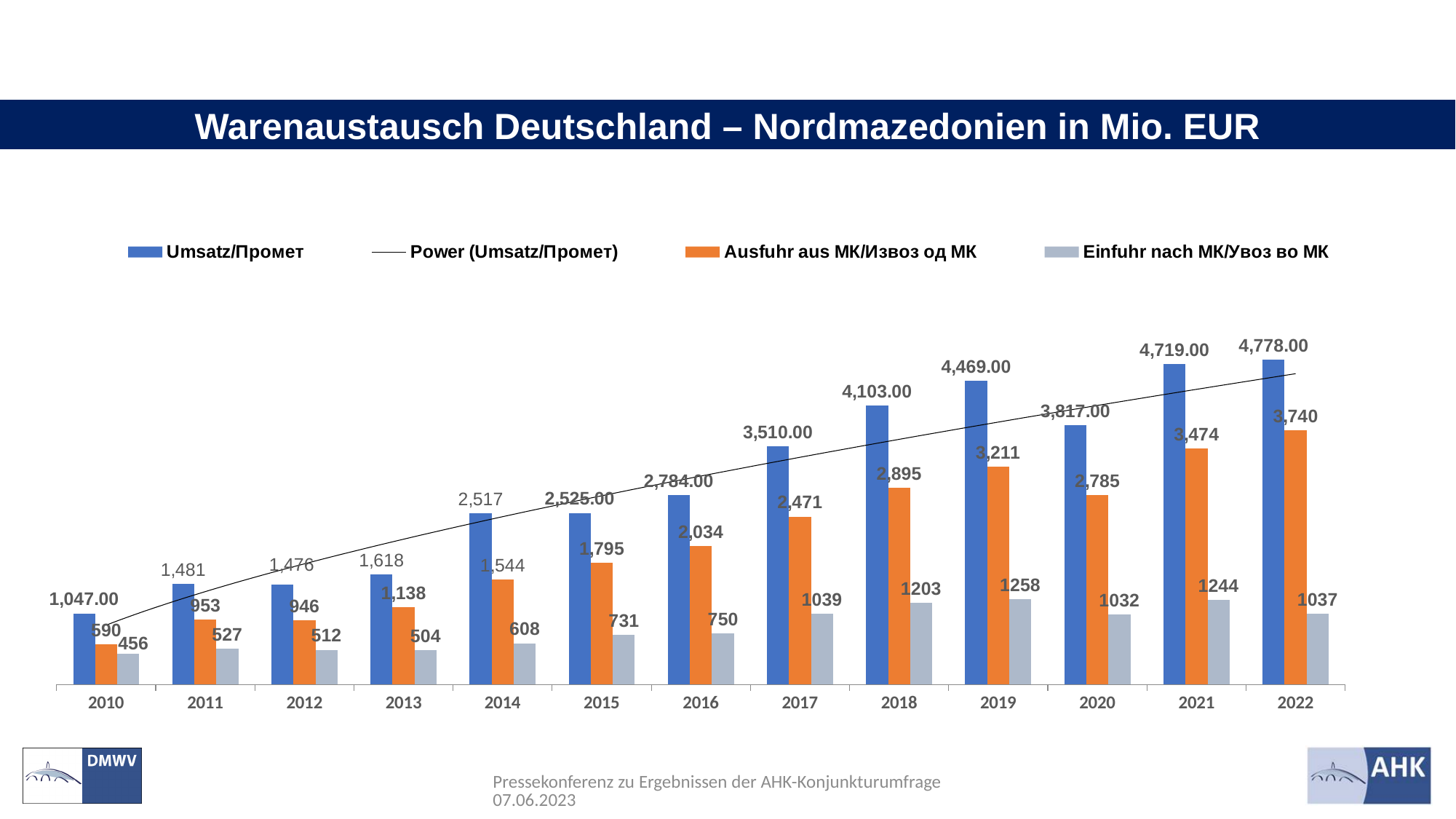
How many years are shown on the x axis? 13 What is the Umsatz/Промет value for 2022? 4,778.00 Which year has the larger Umsatz/Промет value, 2019 or 2020? 2019 What is the difference between the Ausfuhr aus MK/Извоз од МК values for 2019 and 2018? 316 What is the Einfuhr nach MK/Увоз во МК value for 2019? 1258 What is the Umsatz/Промет value for 2014? 2,517 How many entries does the legend list? 4 What is the Ausfuhr aus MK/Извоз од МК value for 2017? 2,471 Does the Umsatz/Промет value generally rise or fall from 2010 to 2022? Rise In which year is the Einfuhr nach MK/Увоз во МК value the lowest? 2010 In which year is the Umsatz/Промет value the highest? 2022 What kind of chart is shown on the slide? Bar chart with a trend line